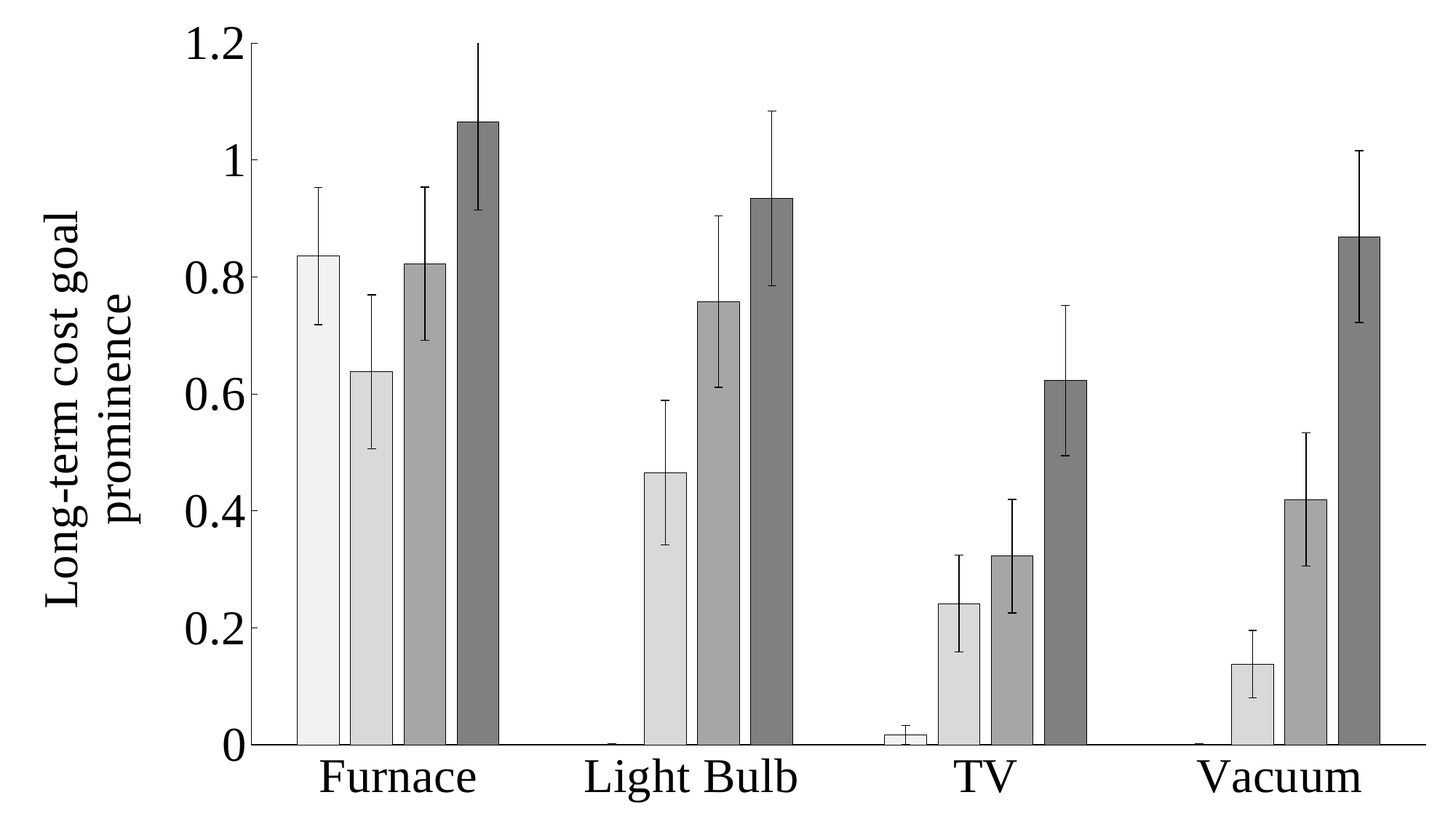
Which category has the shortest darkest (fourth) bar? TV For TV, which is taller: the third bar or the fourth bar? the fourth bar How many categories are shown on the x axis? 4 Is the value of the third bar for Vacuum greater or less than 0.6? less What kind of chart is shown on the slide? bar chart Is the value of the darkest bar for TV greater or less than 0.8? less How many bars are plotted for each category? 4 Is the value of the darkest bar for Furnace greater or less than 1? greater Which category has the tallest darkest (fourth) bar? Furnace What is the highest tick value shown on the y axis? 1.2 What is the label of the y axis? Long-term cost goal prominence